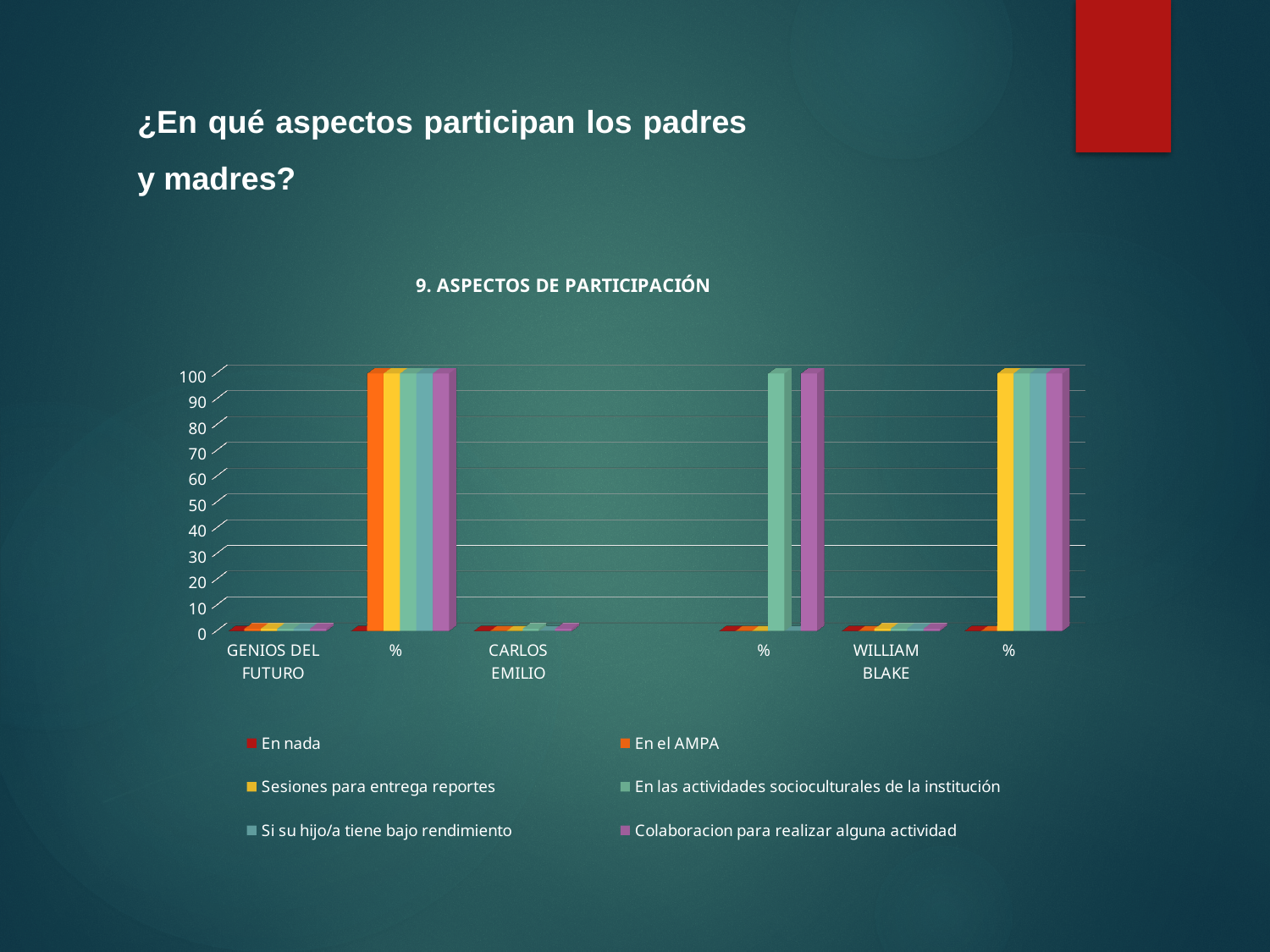
In the middle '%' group (between CARLOS EMILIO and WILLIAM BLAKE), is the value for 'En el AMPA' greater or less than 10? less In the middle '%' group, which is larger: the value for 'Colaboracion para realizar alguna actividad' or the value for 'En nada'? Colaboracion para realizar alguna actividad Which series is shown in purple in the legend? Colaboracion para realizar alguna actividad What is the title of the chart? 9. ASPECTOS DE PARTICIPACIÓN In the '%' group next to GENIOS DEL FUTURO, is the value for 'En el AMPA' greater or less than 90? greater In the '%' group next to WILLIAM BLAKE, is the value for 'En nada' greater or less than 10? less In the '%' group next to GENIOS DEL FUTURO, which series has the lowest value? En nada How many series does the chart legend list? 6 What kind of chart is shown on the slide? bar chart